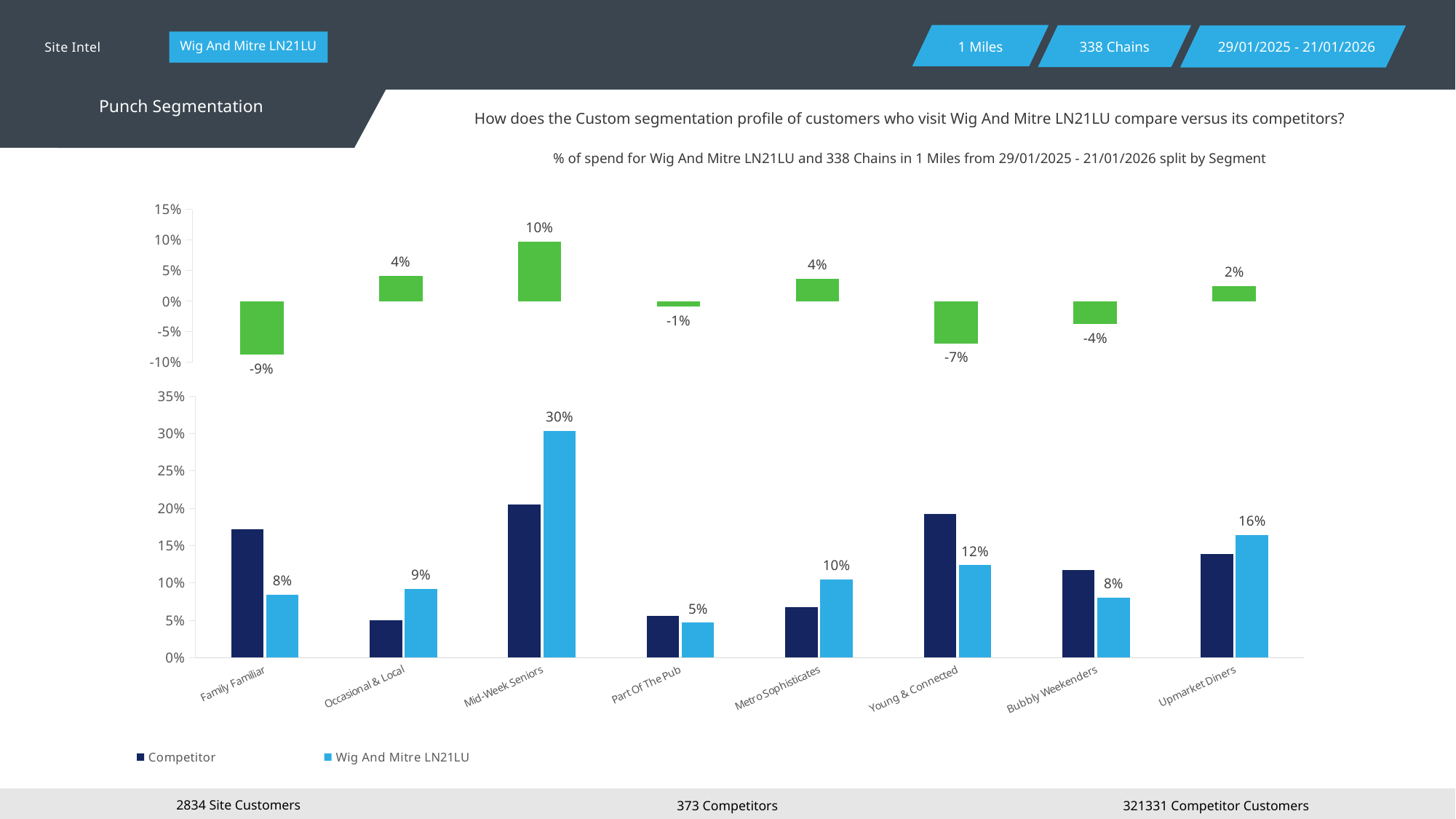
In the bottom chart, what is the difference between the Wig And Mitre LN21LU values for Mid-Week Seniors and Upmarket Diners? 14 percentage points In the bottom chart, is the Competitor value for Young & Connected greater or less than 15%? greater In the top chart, what is the difference between the values for Mid-Week Seniors and Family Familiar? 19 percentage points In the top chart, which segment has the lowest value? Family Familiar How many segments are shown on the x axis of the bottom chart? 8 In the top chart, which segment has the highest value? Mid-Week Seniors In the top chart, what is the value shown for Family Familiar? -9% What type of chart is the bottom chart? Bar chart How many series does the legend of the bottom chart list? 2 In the bottom chart, what is the value for Wig And Mitre LN21LU in the Mid-Week Seniors segment? 30% In the bottom chart, for Family Familiar, which series has the larger value: Competitor or Wig And Mitre LN21LU? Competitor In the bottom chart, which segment has the lowest value for Wig And Mitre LN21LU? Part Of The Pub